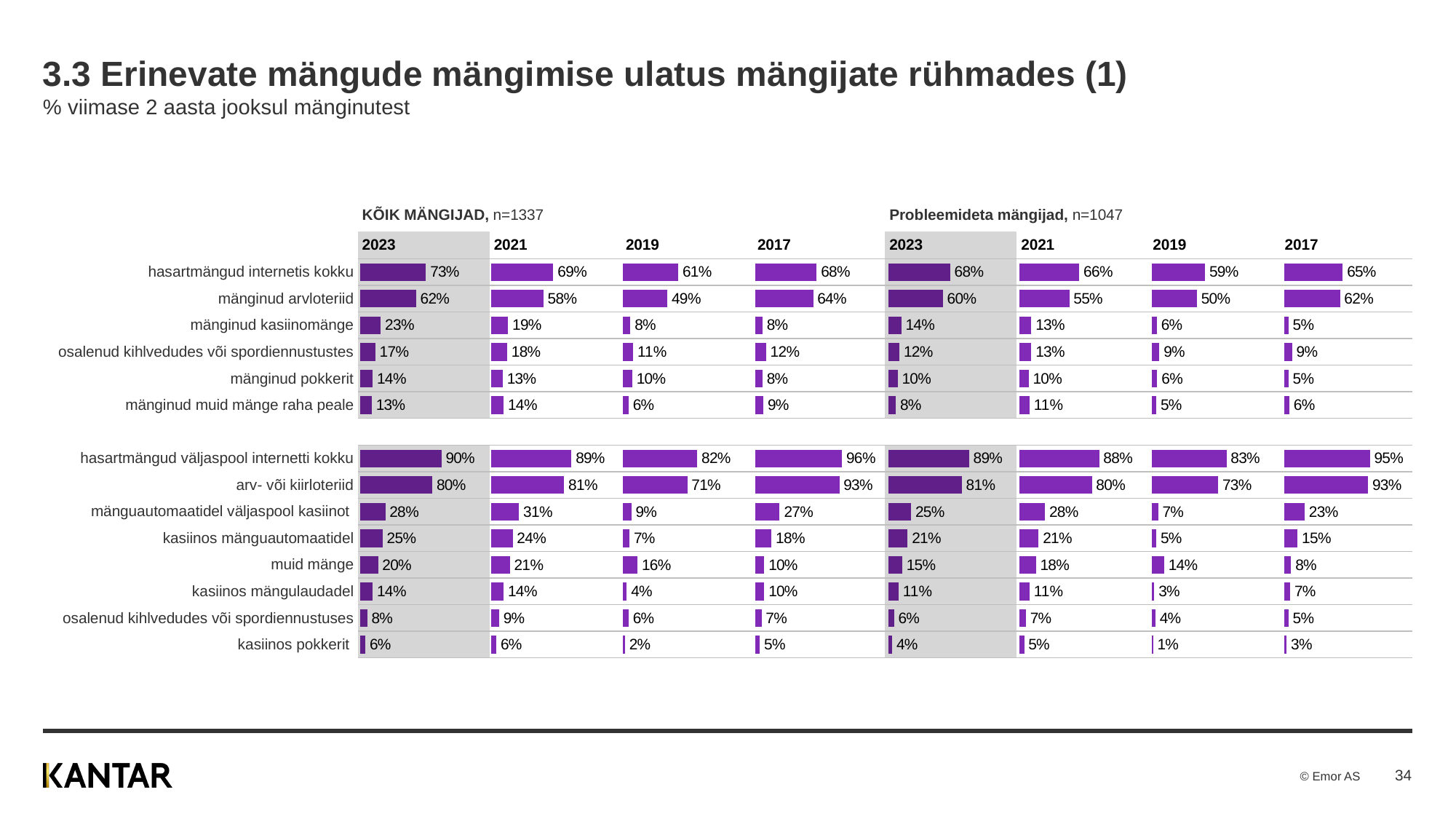
In the KÕIK MÄNGIJAD group, which is larger for 'mänginud arvloteriid': the 2023 value or the 2017 value? 2017 In the Probleemideta mängijad group, what is the 2021 value for 'mänguautomaatidel väljaspool kasiinot'? 28% In the Probleemideta mängijad group, which is larger for 'kasiinos mänguautomaatidel': the 2023 value or the 2017 value? 2023 How many year columns are shown for each player group? 4 In the KÕIK MÄNGIJAD group, what is the 2019 value for 'kasiinos pokkerit'? 2% In the Probleemideta mängijad 2019 column, which category has the lowest value? kasiinos pokkerit What type of chart is used to show the values on this slide? Bar chart In the KÕIK MÄNGIJAD 2023 column, which category has the highest value? hasartmängud väljaspool internetti kokku In the Probleemideta mängijad group, what is the 2017 value for 'arv- või kiirloteriid'? 93% In the KÕIK MÄNGIJAD group, what is the 2023 value for 'hasartmängud internetis kokku'? 73% In the KÕIK MÄNGIJAD group, what is the difference between the 2023 and 2019 values for 'mänginud kasiinomänge'? 15 percentage points In the Probleemideta mängijad group, what is the difference between the 2017 and 2023 values for 'hasartmängud väljaspool internetti kokku'? 6 percentage points